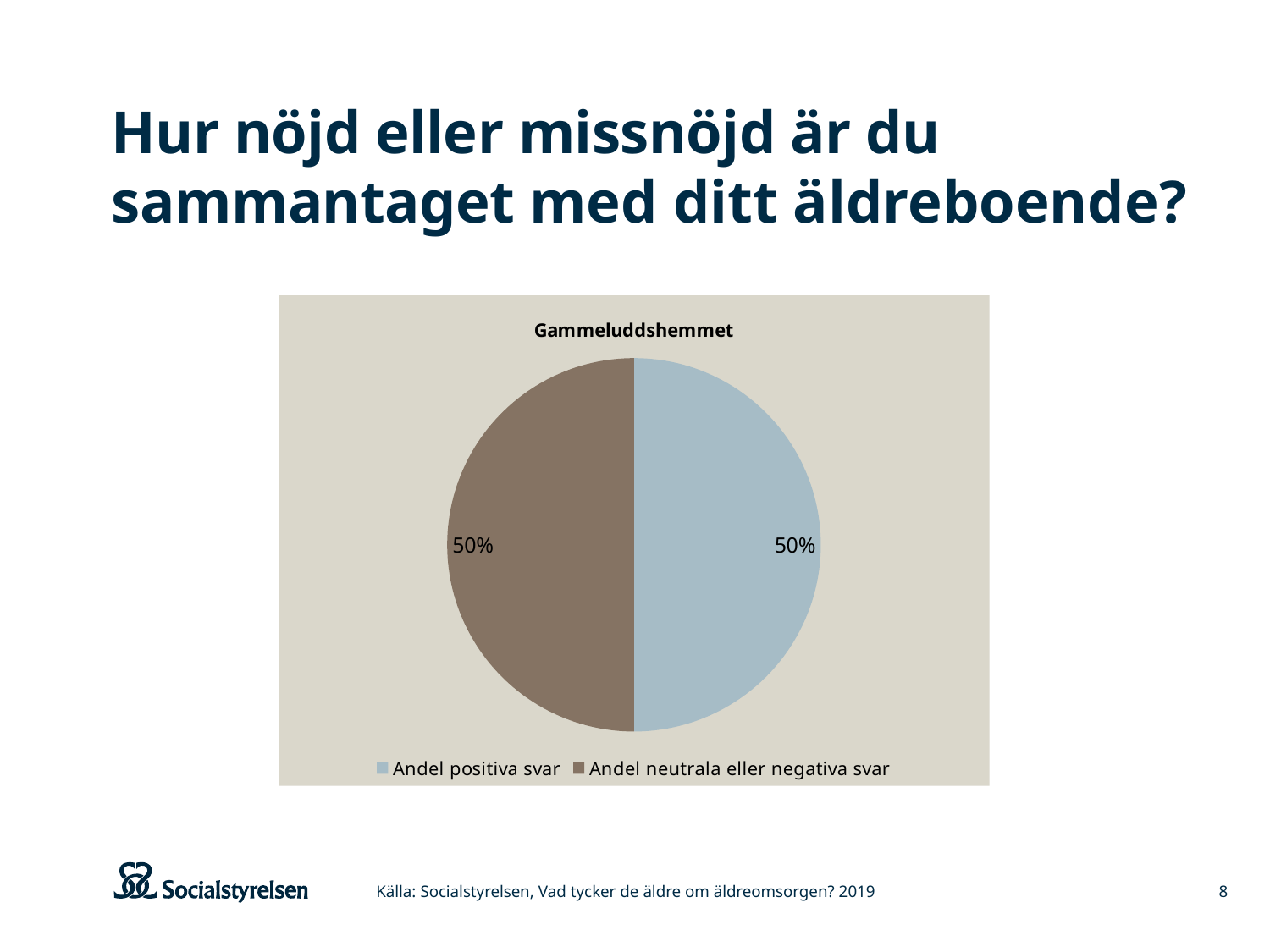
What share of the pie does 'Andel neutrala eller negativa svar' represent? 50% What value is printed on the brown slice of the pie chart? 50% What is the title of the pie chart? Gammeluddshemmet What share of the pie does 'Andel positiva svar' represent? 50% How many entries does the legend of the pie chart list? 2 Which legend entry is shown in brown? Andel neutrala eller negativa svar Are the slices for 'Andel positiva svar' and 'Andel neutrala eller negativa svar' equal in size? yes What kind of chart is shown on the slide? pie chart How many slices does the pie chart have? 2 What is the difference in percentage points between 'Andel positiva svar' and 'Andel neutrala eller negativa svar'? 0 percentage points What value is printed on the light blue slice of the pie chart? 50%